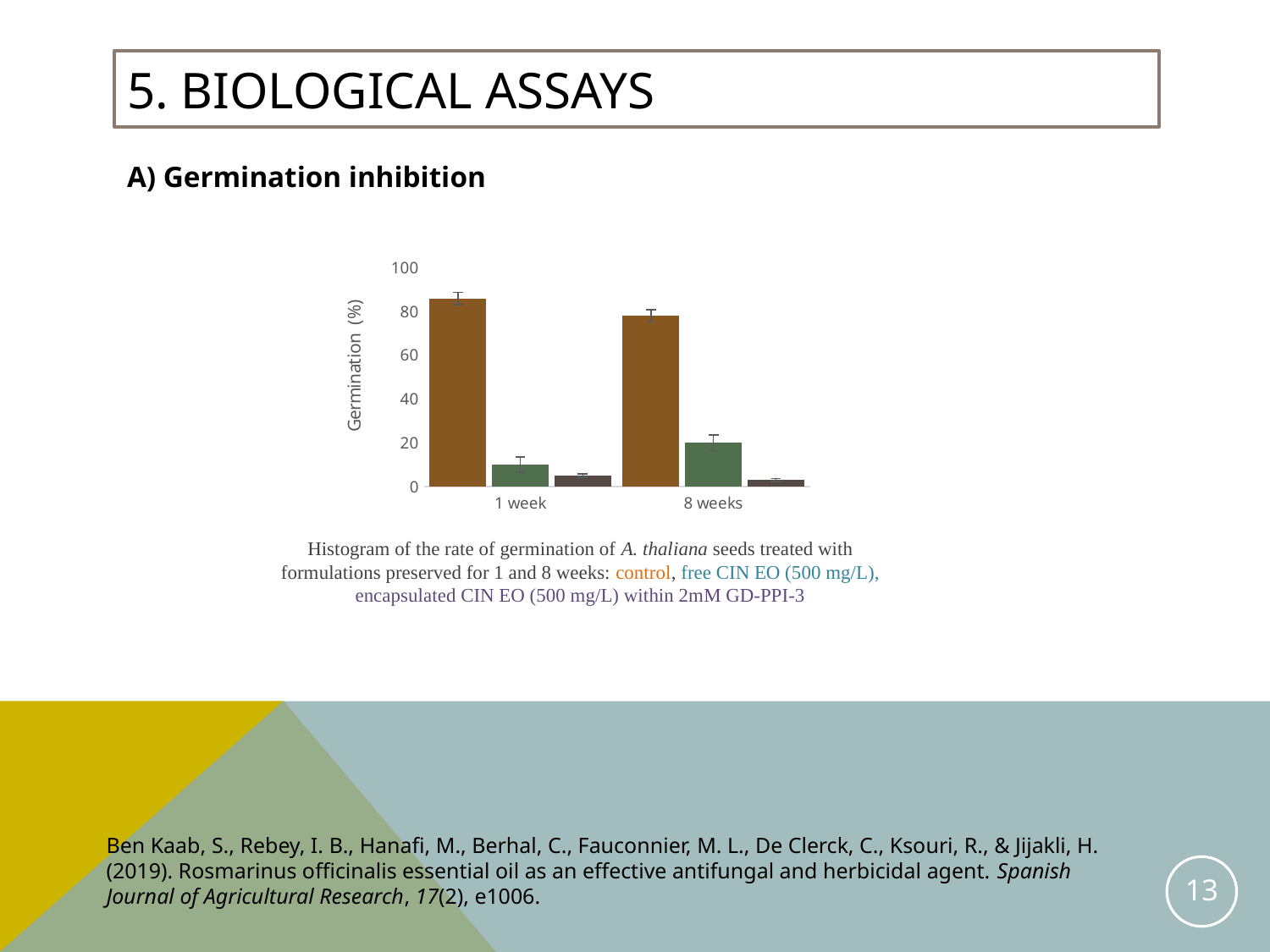
Is the value of the free CIN EO (green) bar at 8 weeks greater or less than 40? less Which bar is the tallest in the chart? control at 1 week Is the value of the free CIN EO (green) bar at 1 week greater or less than 20? less Is the value of the encapsulated CIN EO (dark) bar at 8 weeks greater or less than 20? less How many categories are shown on the x axis of the chart? 2 Which is larger: the free CIN EO (green) bar at 1 week or at 8 weeks? 8 weeks What is the label of the y axis of the chart? Germination (%) What kind of chart is shown on the slide? bar chart Does the control (brown) bar rise or fall from 1 week to 8 weeks? fall What are the two categories on the x axis of the chart? 1 week and 8 weeks